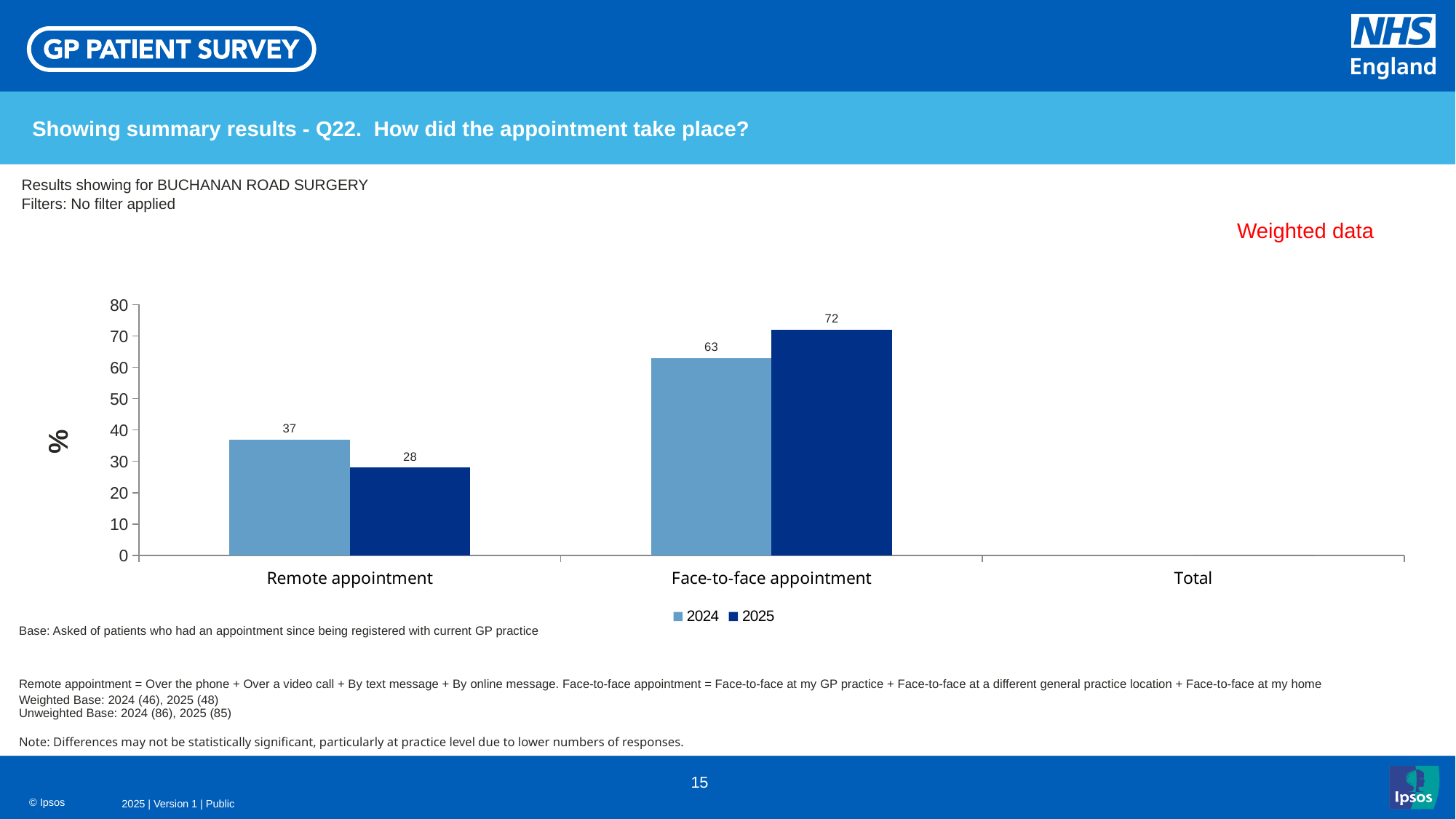
What is the value for Remote appointment in 2025? 28 How many series does the legend list? 2 What is the difference between the 2025 and 2024 values for Face-to-face appointment? 9 What is the value for Remote appointment in 2024? 37 What is the difference between the 2024 and 2025 values for Remote appointment? 9 Which practice are the results shown for? BUCHANAN ROAD SURGERY Which is larger for Remote appointment: the 2024 value or the 2025 value? 2024 Which bar has the lowest value on the chart? Remote appointment, 2025 Which bar has the highest value on the chart? Face-to-face appointment, 2025 What kind of chart is shown on the slide? Bar chart What is the value for Face-to-face appointment in 2024? 63 What is the value for Face-to-face appointment in 2025? 72